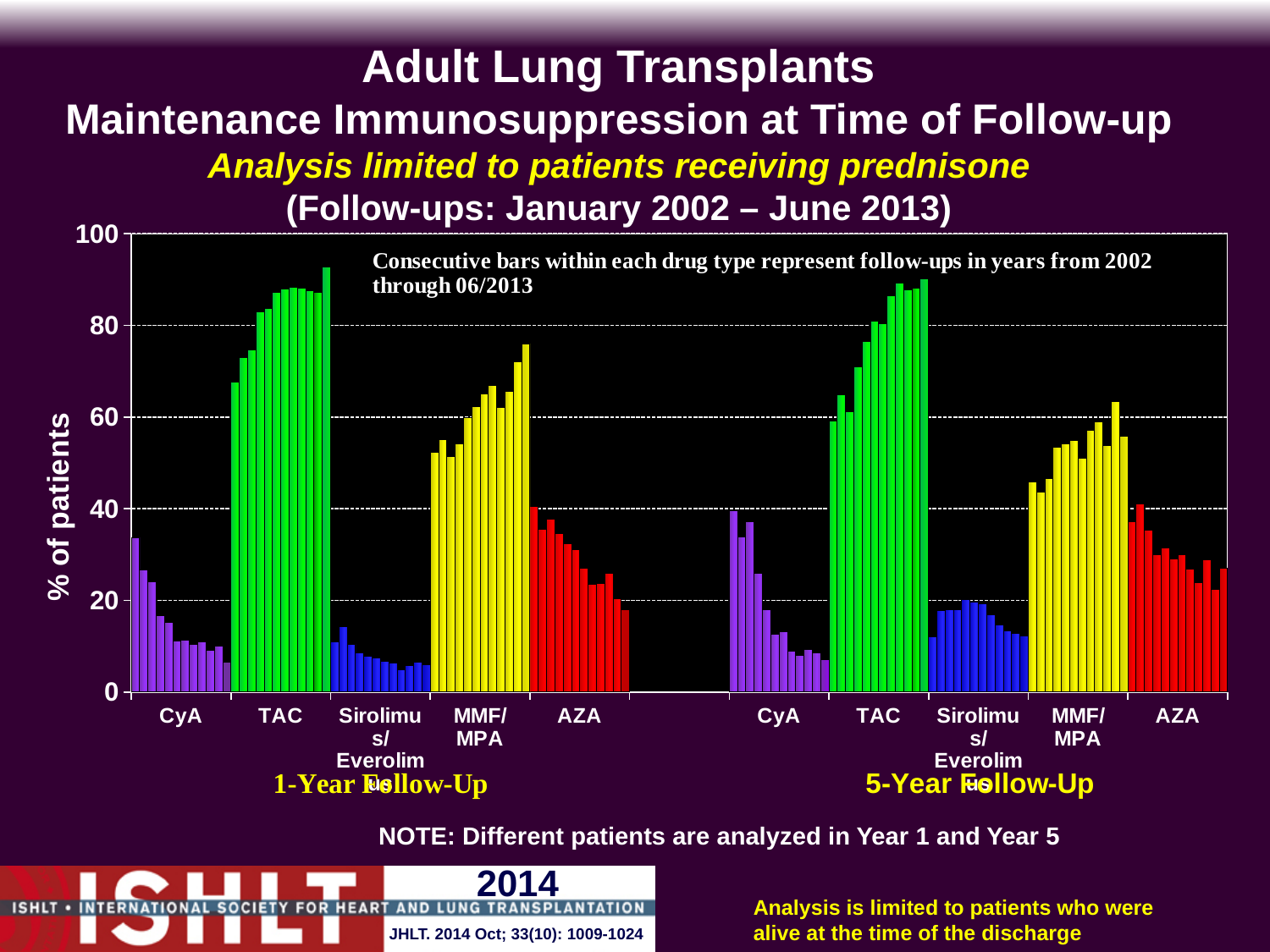
In the 5-Year Follow-Up chart, which drug type has higher values, TAC or AZA? TAC In the 5-Year Follow-Up chart, is the first (2002) CyA bar greater or less than 60? less What do consecutive bars within each drug type represent, according to the note on the chart? Follow-ups in years from 2002 through 06/2013 In the 1-Year Follow-Up chart, do the TAC bars rise or fall across the follow-up years from 2002 to 2013? rise In the 1-Year Follow-Up chart, is the tallest TAC bar greater or less than 80? greater In the 1-Year Follow-Up chart, which drug type has the highest percentage of patients? TAC In the 5-Year Follow-Up chart, do the CyA bars rise or fall across the follow-up years from 2002 to 2013? fall What is the label on the y axis of the charts? % of patients In the 1-Year Follow-Up chart, are all the Sirolimus/Everolimus bars greater or less than 20? less What kind of chart is shown on the slide? bar chart In the 5-Year Follow-Up chart, which drug type has the lowest percentage of patients? Sirolimus/Everolimus How many drug types are shown on the x axis of the 1-Year Follow-Up chart? 5